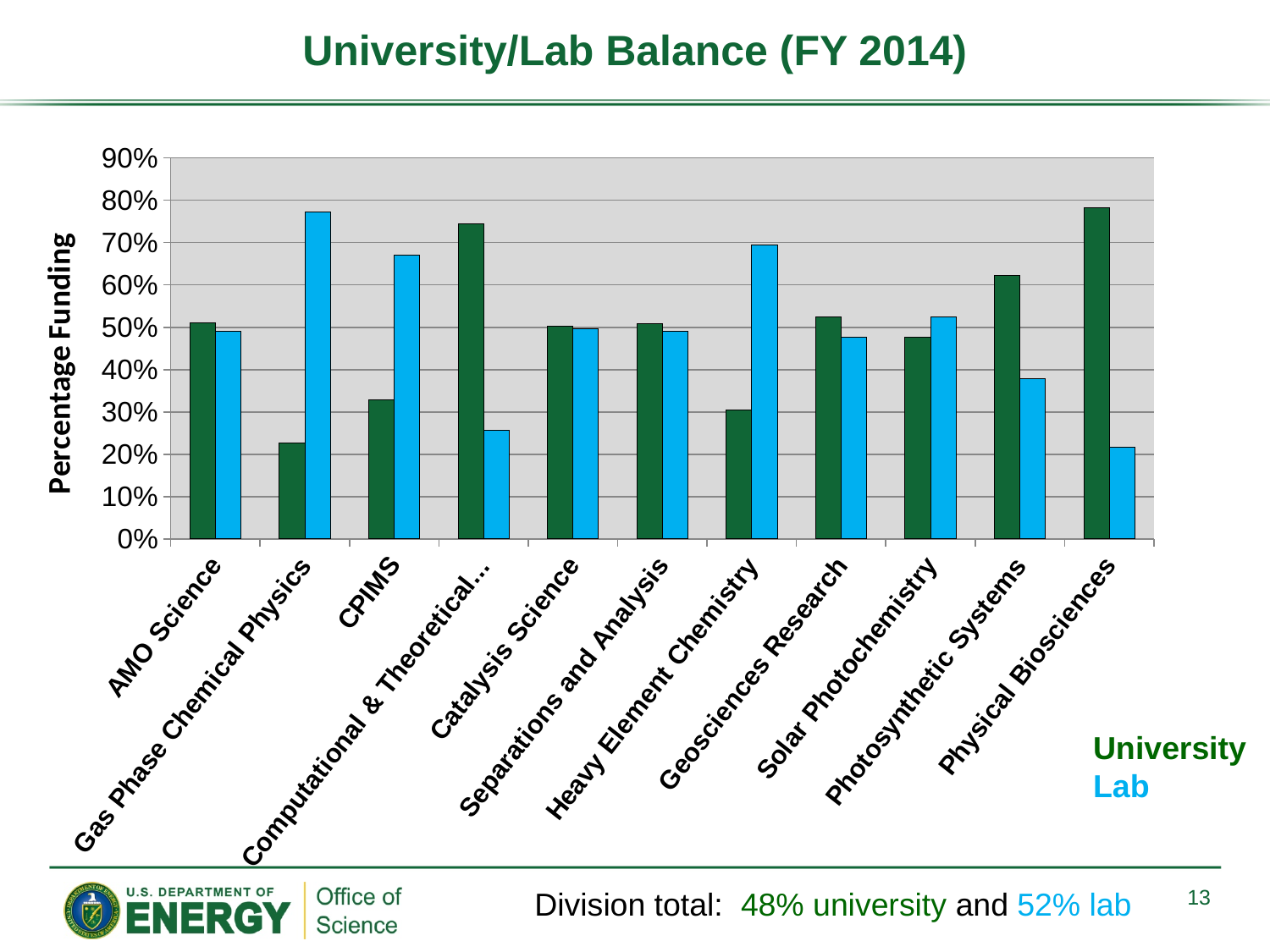
How many categories are shown on the x axis of the chart? 11 What is the label of the chart's y axis? Percentage Funding What kind of chart is shown on the slide? bar chart For Photosynthetic Systems, which is larger, the University value or the Lab value? University Which category has the highest University value? Physical Biosciences Which category has the lowest University value? Gas Phase Chemical Physics Which category has the highest Lab value? Gas Phase Chemical Physics For Heavy Element Chemistry, which is larger, the University value or the Lab value? Lab How many series does the chart's legend list? 2 Is the Lab value for Photosynthetic Systems greater or less than 50%? less Is the University value for Heavy Element Chemistry greater or less than 40%? less Is the Lab value for Gas Phase Chemical Physics greater or less than 70%? greater